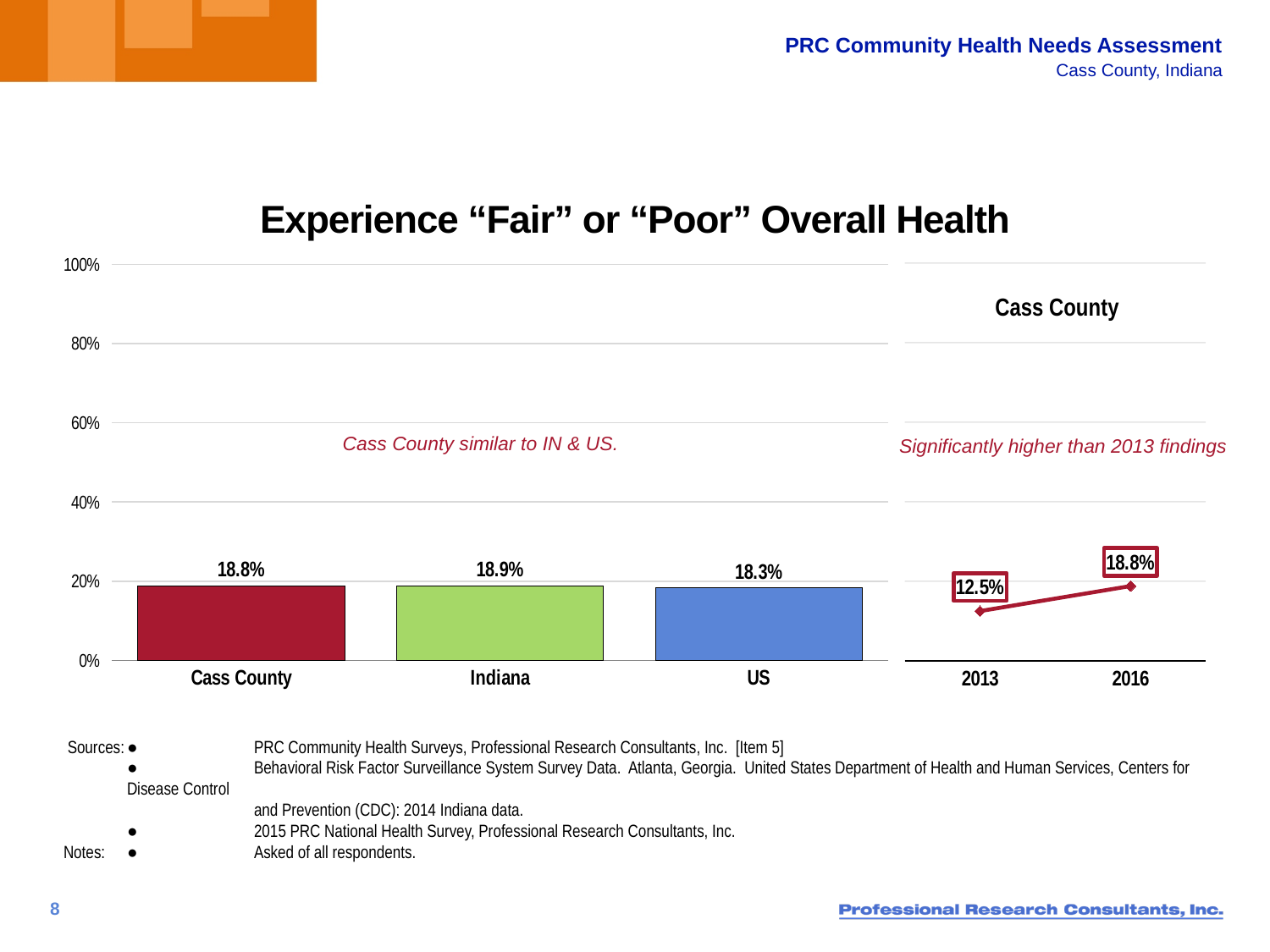
In the left bar chart, what is the difference between the Indiana value and the US value? 0.6% In the right Cass County chart, what is the value for 2013? 12.5% In the right Cass County chart, do the values rise or fall from 2013 to 2016? Rise In the left bar chart, what is the value for Cass County? 18.8% What kind of chart is the left chart? Bar chart In the left bar chart, how many categories are shown? 3 In the left bar chart, what is the value for Indiana? 18.9% In the right Cass County chart, what is the difference between the 2016 value and the 2013 value? 6.3% In the left bar chart, which category has the lowest value? US In the left bar chart, which category has the highest value? Indiana In the right Cass County chart, what is the value for 2016? 18.8% In the left bar chart, what is the value for US? 18.3%